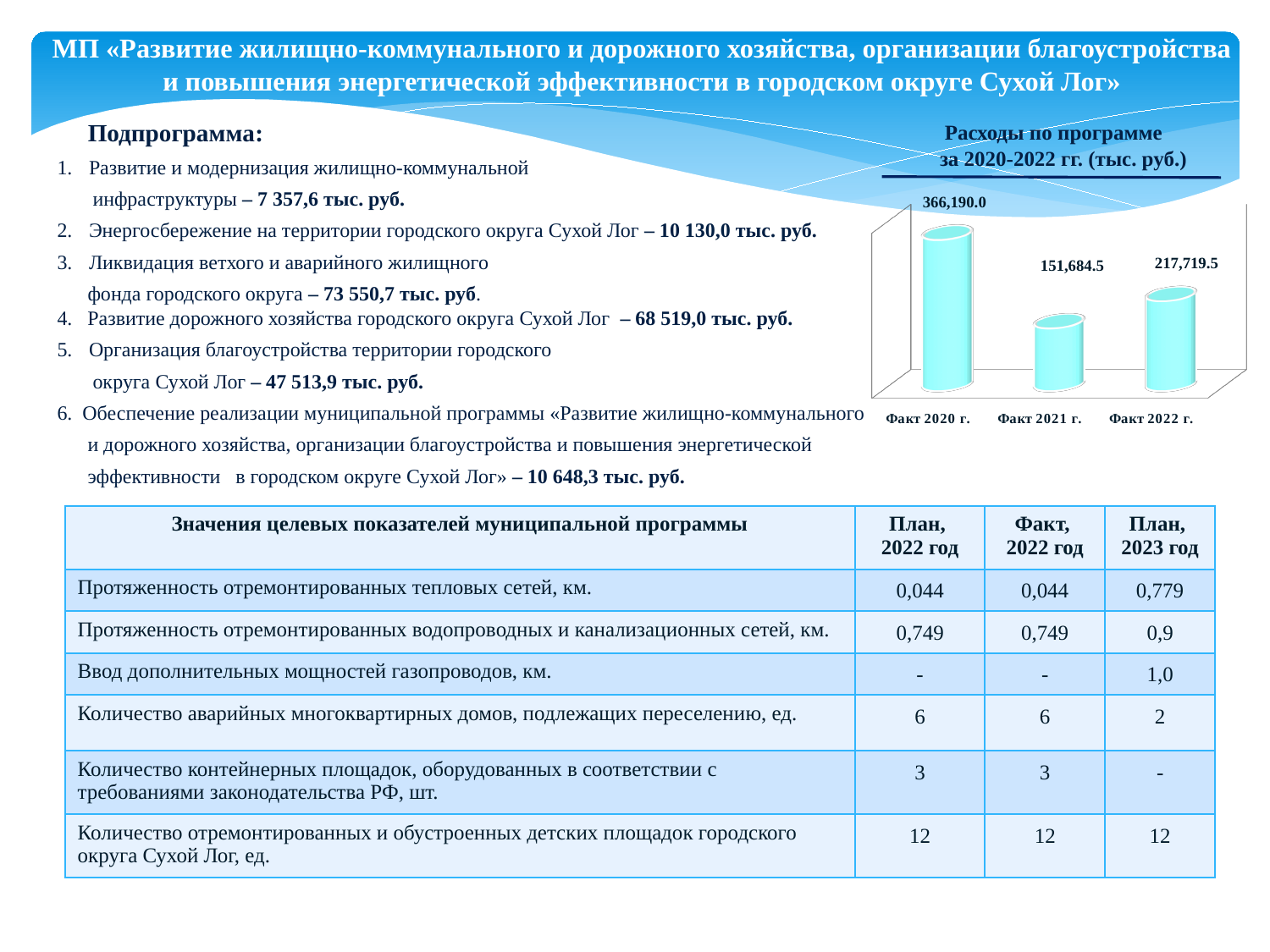
In the chart «Расходы по программе за 2020-2022 гг. (тыс. руб.)», which is larger: the value for Факт 2021 г. or Факт 2022 г.? Факт 2022 г. In the chart «Расходы по программе за 2020-2022 гг. (тыс. руб.)», do the values rise or fall from Факт 2020 г. to Факт 2021 г.? Fall What kind of chart is «Расходы по программе за 2020-2022 гг. (тыс. руб.)»? Bar chart In the chart «Расходы по программе за 2020-2022 гг. (тыс. руб.)», what is the difference between the values for Факт 2020 г. and Факт 2021 г.? 214,505.5 Which category has the lowest value in the chart «Расходы по программе за 2020-2022 гг. (тыс. руб.)»? Факт 2021 г. What is the title of the chart on the slide? Расходы по программе за 2020-2022 гг. (тыс. руб.) In the chart «Расходы по программе за 2020-2022 гг. (тыс. руб.)», what is the difference between the values for Факт 2022 г. and Факт 2021 г.? 66,035.0 How many categories are shown in the chart «Расходы по программе за 2020-2022 гг. (тыс. руб.)»? 3 Which category has the highest value in the chart «Расходы по программе за 2020-2022 гг. (тыс. руб.)»? Факт 2020 г. What is the value for Факт 2021 г. in the chart «Расходы по программе за 2020-2022 гг. (тыс. руб.)»? 151,684.5 What is the value for Факт 2022 г. in the chart «Расходы по программе за 2020-2022 гг. (тыс. руб.)»? 217,719.5 What is the value for Факт 2020 г. in the chart «Расходы по программе за 2020-2022 гг. (тыс. руб.)»? 366,190.0